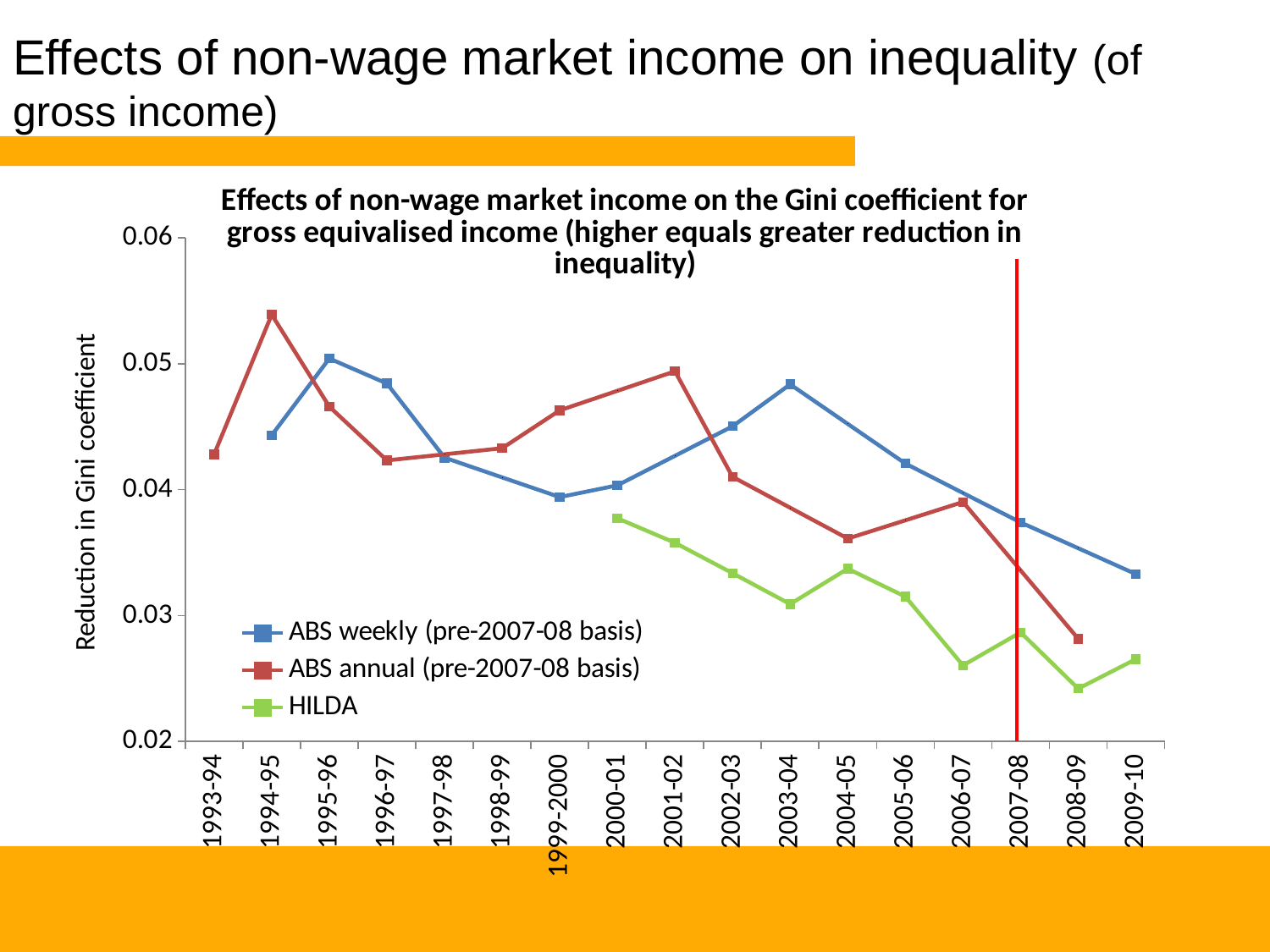
How many series does the legend list? 3 What kind of chart is shown on the slide? line chart Is the value for ABS annual (pre-2007-08 basis) in 1994-95 greater or less than 0.05? greater Is the value for HILDA in 2000-01 greater or less than 0.04? less How many financial years are shown on the x axis? 17 In which year does the HILDA series reach its lowest value? 2008-09 Is the value for HILDA in 2008-09 greater or less than 0.03? less Does the ABS weekly (pre-2007-08 basis) series rise or fall from 2003-04 to 2009-10? fall What is the label on the y axis? Reduction in Gini coefficient In which year does the ABS annual (pre-2007-08 basis) series reach its highest value? 1994-95 In 2008-09, which is larger: the ABS annual (pre-2007-08 basis) value or the HILDA value? ABS annual (pre-2007-08 basis)